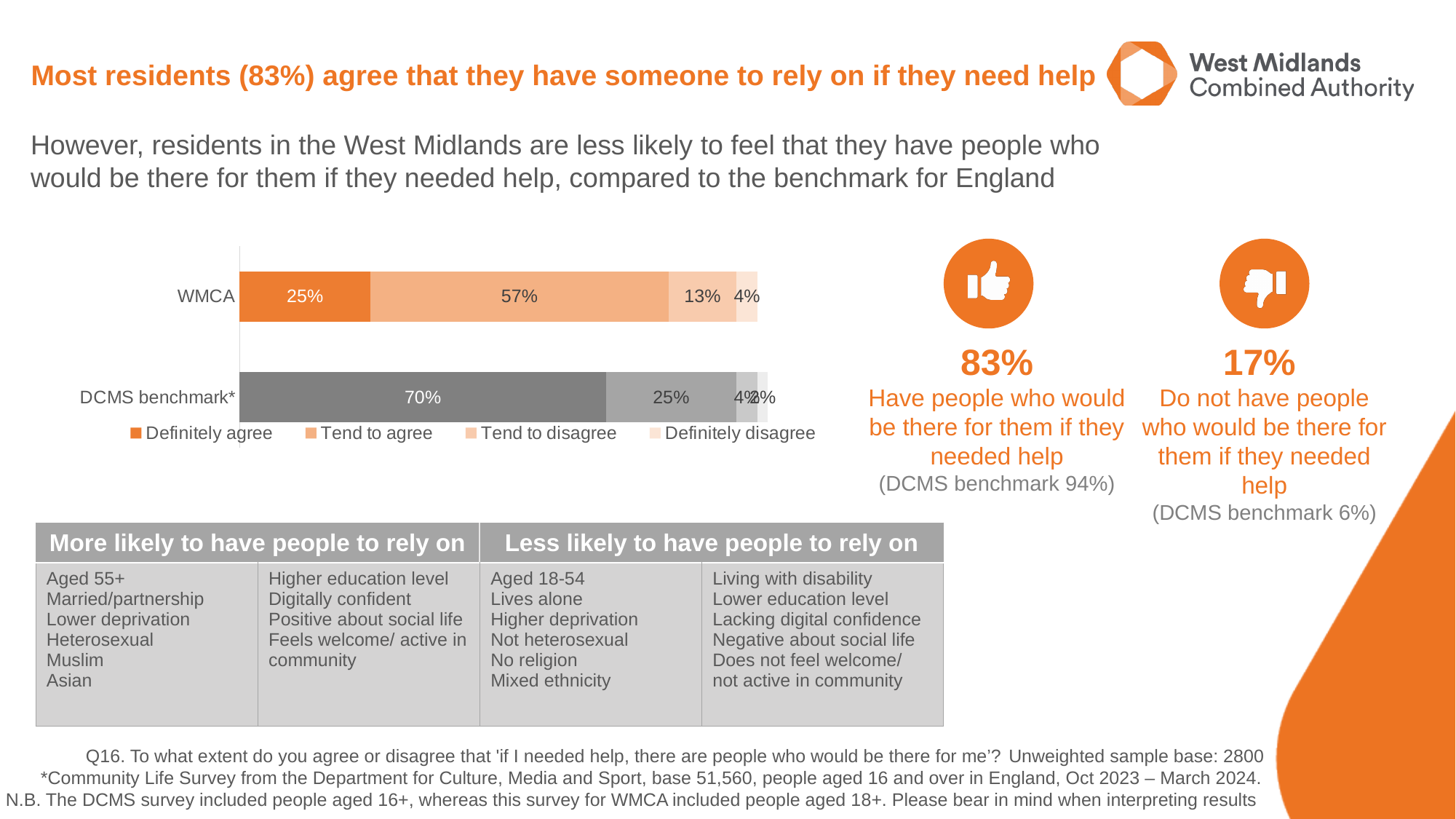
What is the 'Definitely agree' value for the DCMS benchmark* bar? 70% What is the difference in percentage points between the DCMS benchmark* and WMCA for 'Definitely agree'? 45 percentage points How many series does the chart legend list? 4 What is the 'Tend to agree' value for the DCMS benchmark*? 25% What is the 'Tend to agree' value for WMCA in the chart? 57% Which bar has the larger 'Definitely agree' share, WMCA or DCMS benchmark*? DCMS benchmark* What is the 'Tend to disagree' value for WMCA? 13% How many bars (categories) are shown in the chart? 2 What is the 'Definitely disagree' value for WMCA? 4% What percentage of WMCA residents 'Definitely agree' that they have people who would be there for them if they needed help? 25% Which bar has the larger 'Tend to agree' share, WMCA or DCMS benchmark*? WMCA What type of chart is used to show the agreement levels? Stacked bar chart